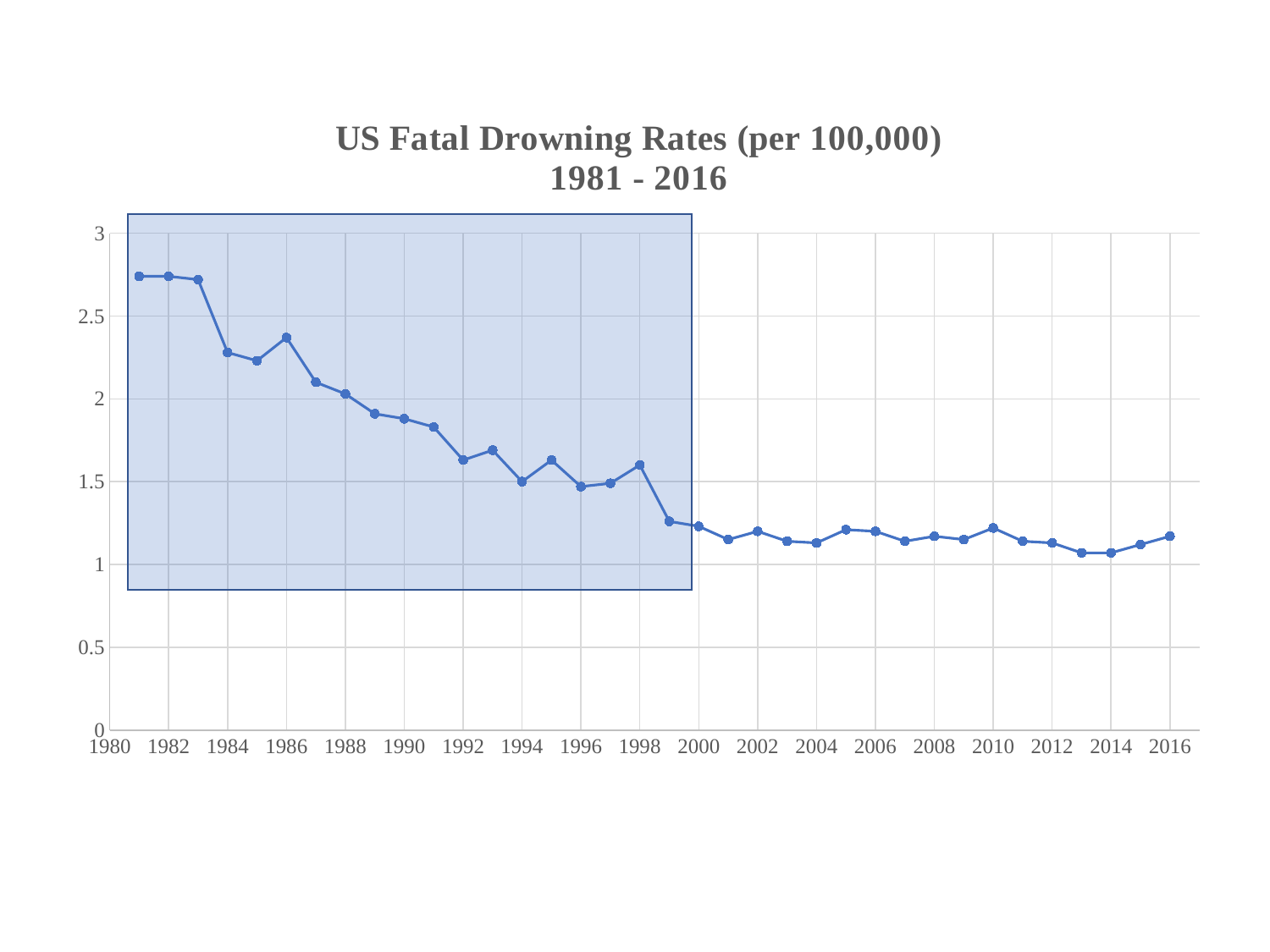
Which year has the higher drowning rate, 1985 or 1986? 1986 Is the value for 2016 greater or less than 1? greater Is the value for 1981 greater or less than 2.5? greater Is the value for 1999 greater or less than 1.5? less Do the drowning rates generally rise or fall from 1981 to 2016? fall Which year has the higher drowning rate, 1981 or 2016? 1981 What kind of chart is shown on the slide? line chart Which year has the higher drowning rate, 1998 or 1999? 1998 What is the title of the chart? US Fatal Drowning Rates (per 100,000) 1981 - 2016 How many years of data are plotted on the chart? 36